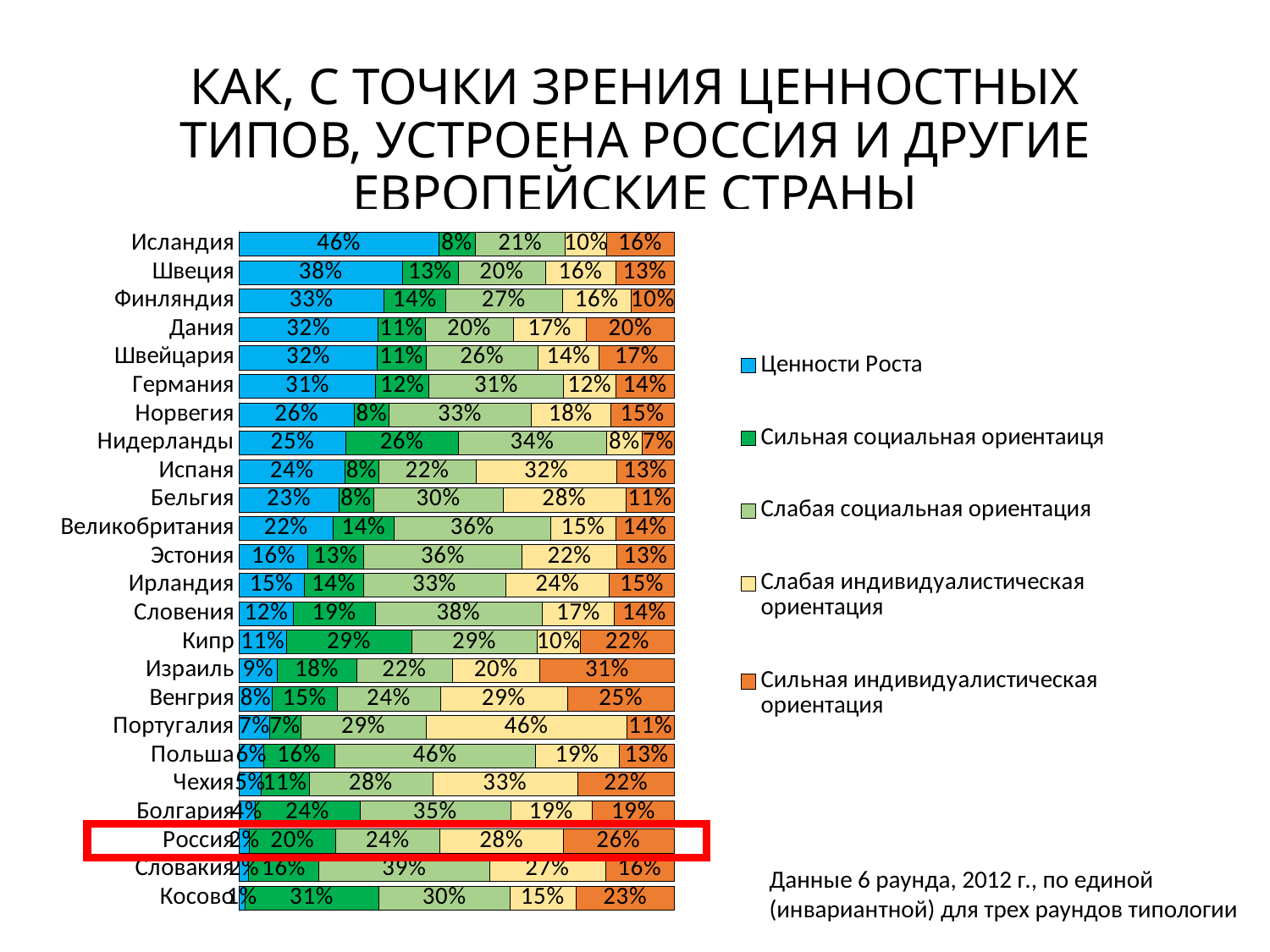
How many series does the legend list? 5 How many countries are listed on the chart? 24 Which is larger: Сильная индивидуалистическая ориентация for Израиль or for Россия? Израиль Which country has the highest value of Ценности Роста? Исландия Which country has the lowest value of Ценности Роста? Косово Which country has the highest value of Сильная индивидуалистическая ориентация? Израиль What is the value of Сильная индивидуалистическая ориентация for Россия? 26% What is the value of Слабая индивидуалистическая ориентация for Португалия? 46% What is the difference in Ценности Роста between Исландия and Швеция? 8 percentage points What is the value of Ценности Роста for Россия? 2% What is the value of Ценности Роста for Исландия? 46% What type of chart is shown on the slide? Stacked bar chart